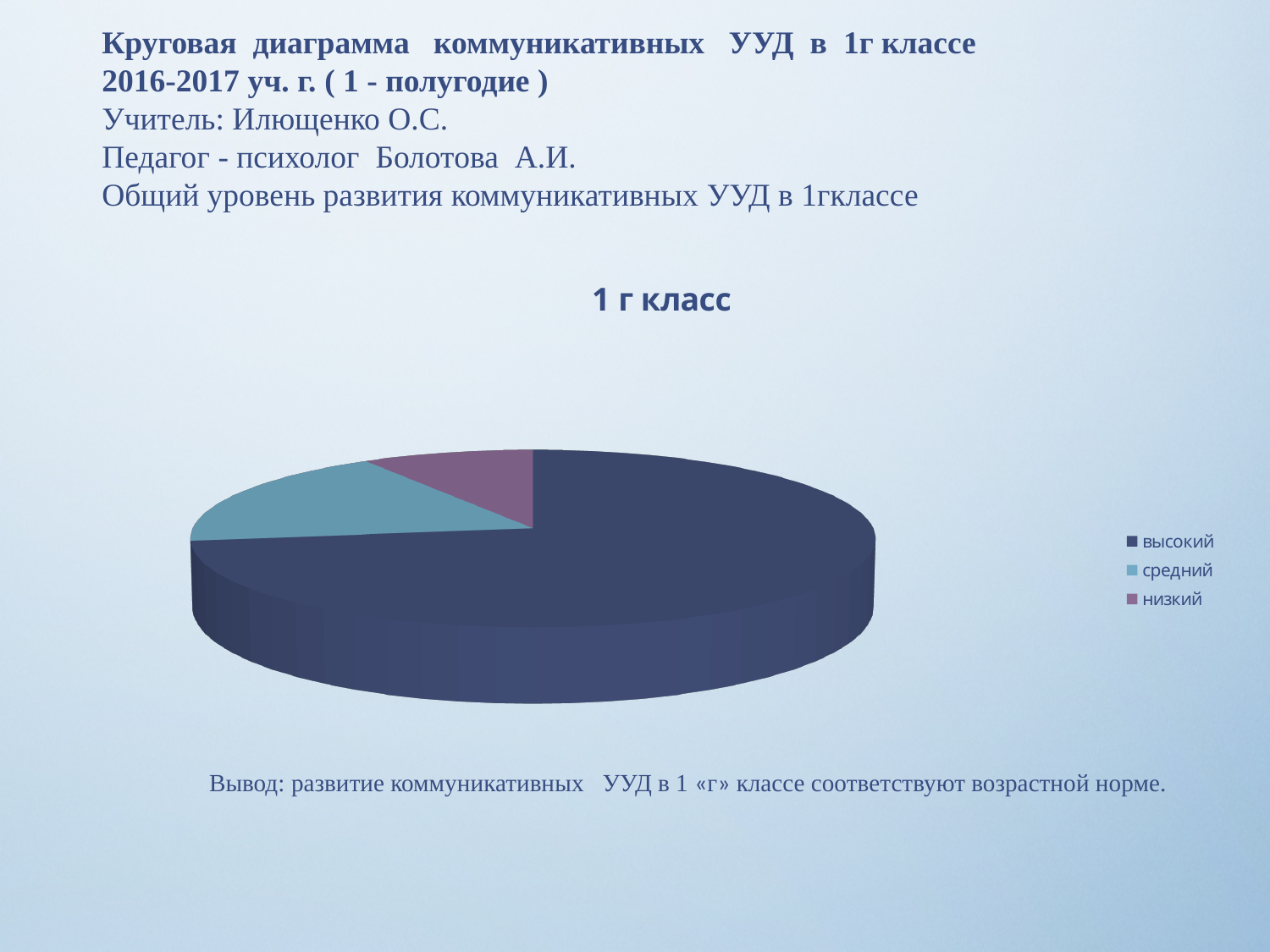
How many entries does the legend list? 3 Which slice is larger, высокий or средний? высокий What kind of chart is shown on the slide? pie chart Which category has the largest slice of the pie? высокий Which legend entry is shown in the dark blue colour? высокий What is the title of the chart? 1 г класс Which category has the smallest slice of the pie? низкий How many slices does the pie chart have? 3 Which slice is larger, средний or низкий? средний